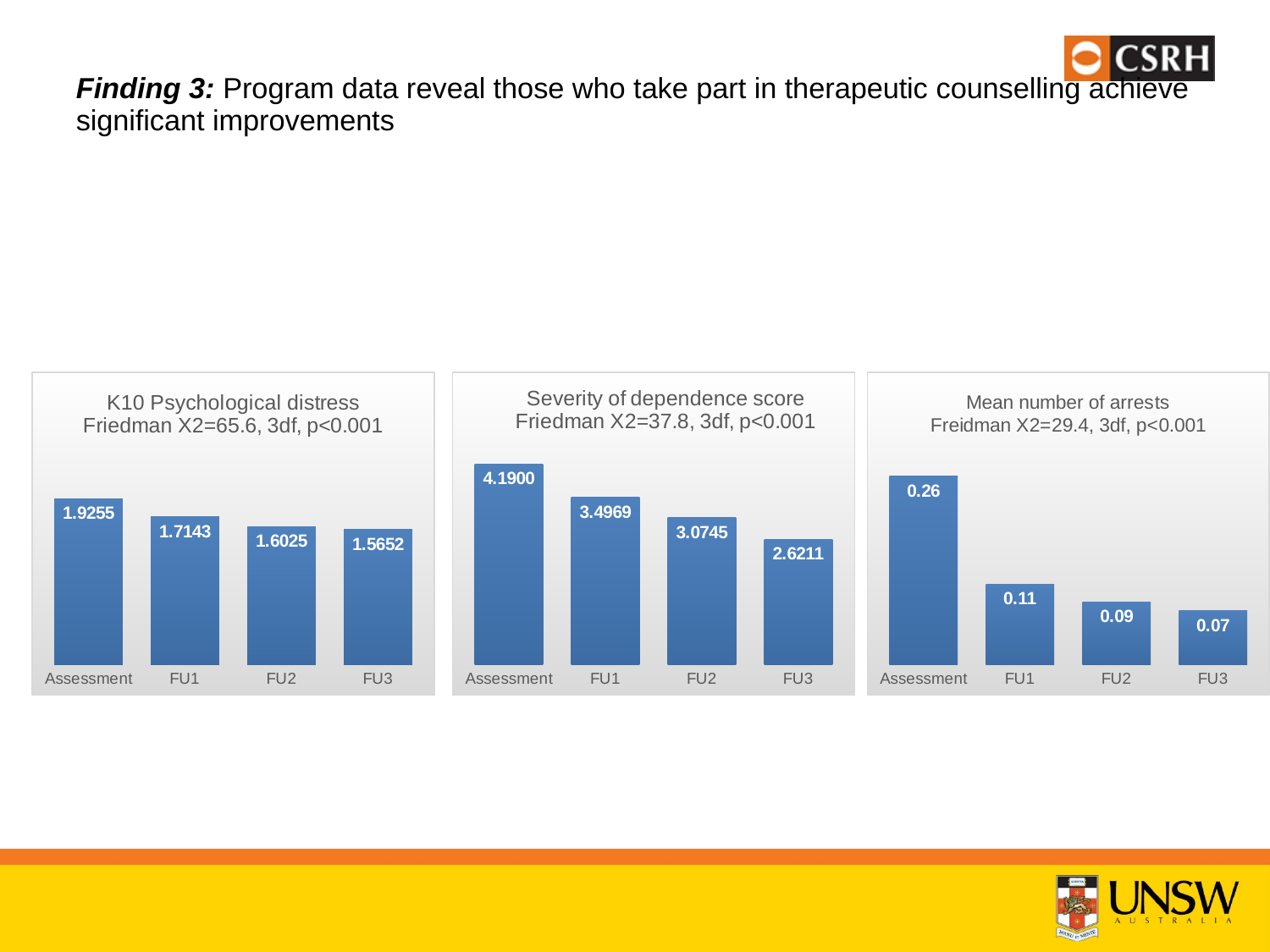
In the K10 Psychological distress chart, what is the value at Assessment? 1.9255 How many time points are shown in the Severity of dependence score chart? 4 In the Mean number of arrests chart, what is the value at FU2? 0.09 What type of chart is the Mean number of arrests chart? Bar chart In the Severity of dependence score chart, what is the value at FU1? 3.4969 In the Mean number of arrests chart, what is the difference between the Assessment value and the FU1 value? 0.15 In the K10 Psychological distress chart, do the values rise or fall from Assessment to FU3? Fall In the K10 Psychological distress chart, which is larger, the value at FU1 or the value at FU2? FU1 In the K10 Psychological distress chart, what is the value at FU3? 1.5652 In the Severity of dependence score chart, which time point has the highest value? Assessment In the Severity of dependence score chart, what is the difference between the Assessment value and the FU3 value? 1.5689 In the Mean number of arrests chart, which time point has the lowest value? FU3